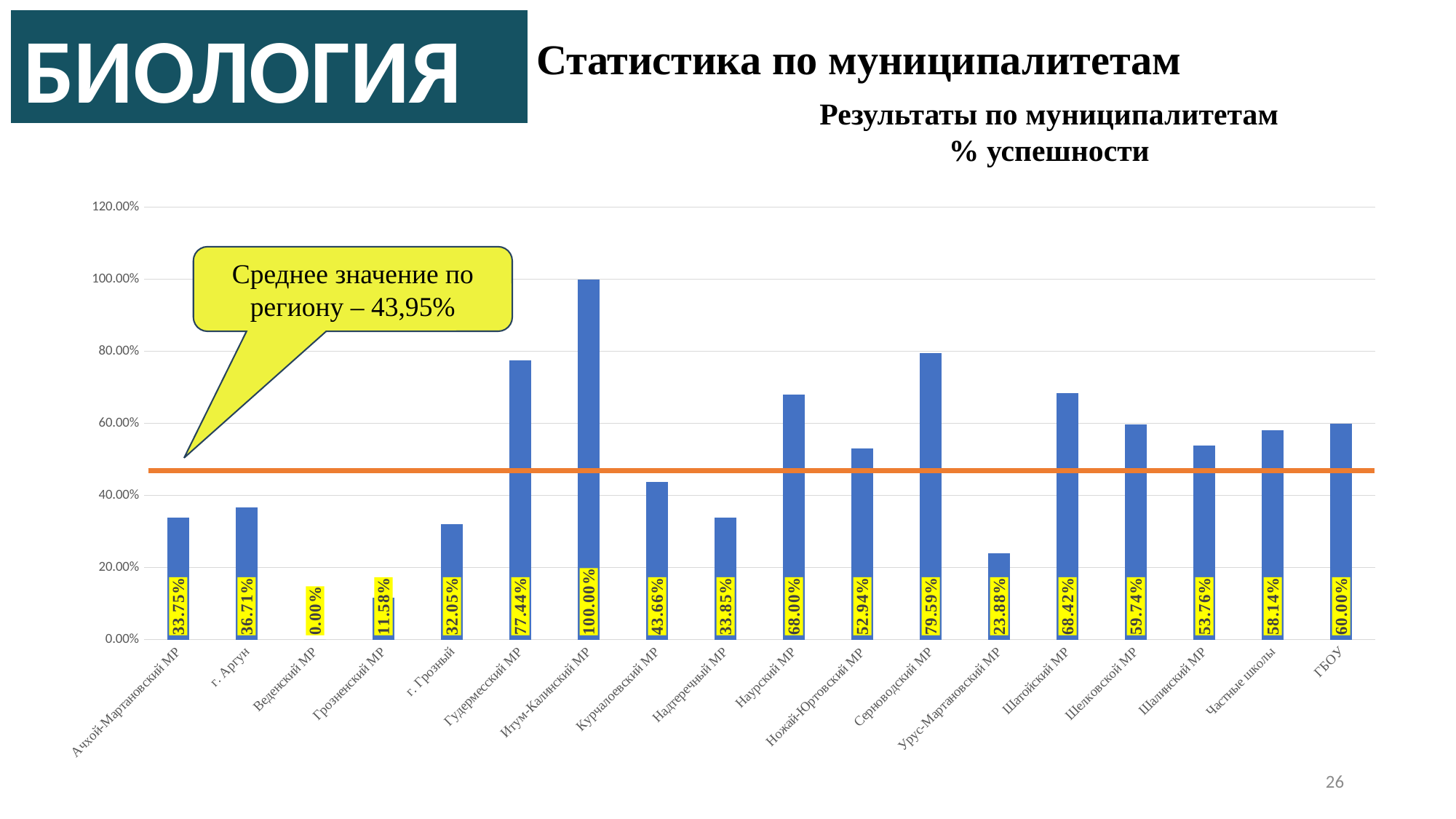
What kind of chart is shown on the slide? bar chart How many categories are shown on the x axis? 18 Which category has the highest value? Итум-Калинский МР What regional average value is stated in the callout on the chart? 43,95% Is the value for Урус-Мартановский МР greater or less than 40.00%? less Which category has the lowest value? Веденский МР What is the difference between the values for Гудермесский МР and Наурский МР? 9.44% What is the value for Грозненский МР? 11.58% What is the value for Итум-Калинский МР? 100.00% Is the value for Серноводский МР greater or less than 60.00%? greater Which is larger, the value for Гудермесский МР or the value for Курчалоевский МР? Гудермесский МР What is the value for Частные школы? 58.14%